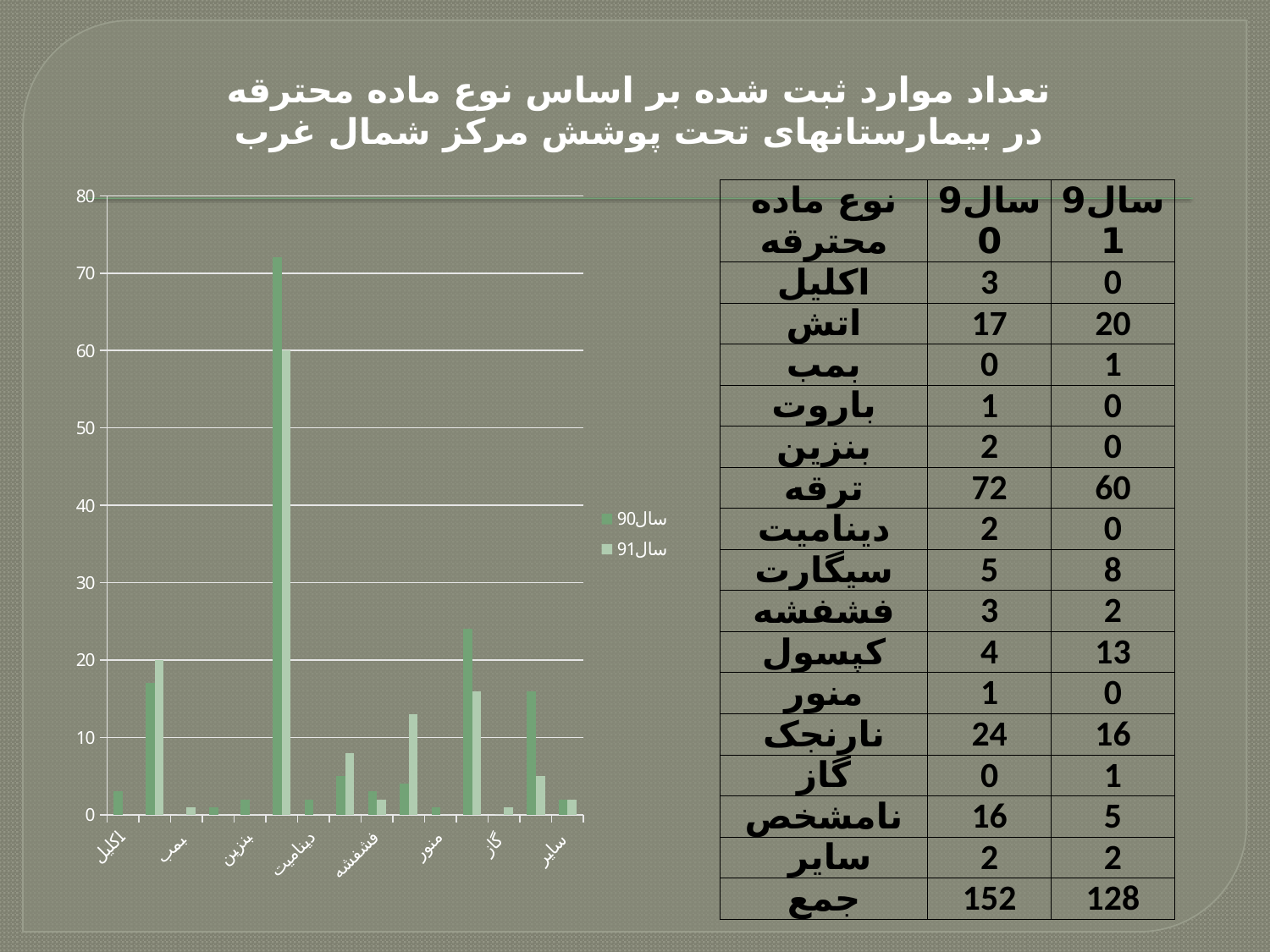
What is the value for نارنجک in سال91? 16 What is the total (جمع) for سال90 shown in the table? 152 Which category has the highest value for سال90? ترقه Is the سال90 bar for ترقه greater or less than 70? greater What are the two series named in the chart legend? سال90 and سال91 How many series does the chart legend list? 2 How many categories of burning material are plotted on the chart? 15 What is the difference between the سال90 and سال91 values for ترقه? 12 What is the value for اتش in سال91? 20 For کپسول, which series has the larger value, سال90 or سال91? سال91 What is the value for ترقه in سال90? 72 What kind of chart is shown on the slide? bar chart